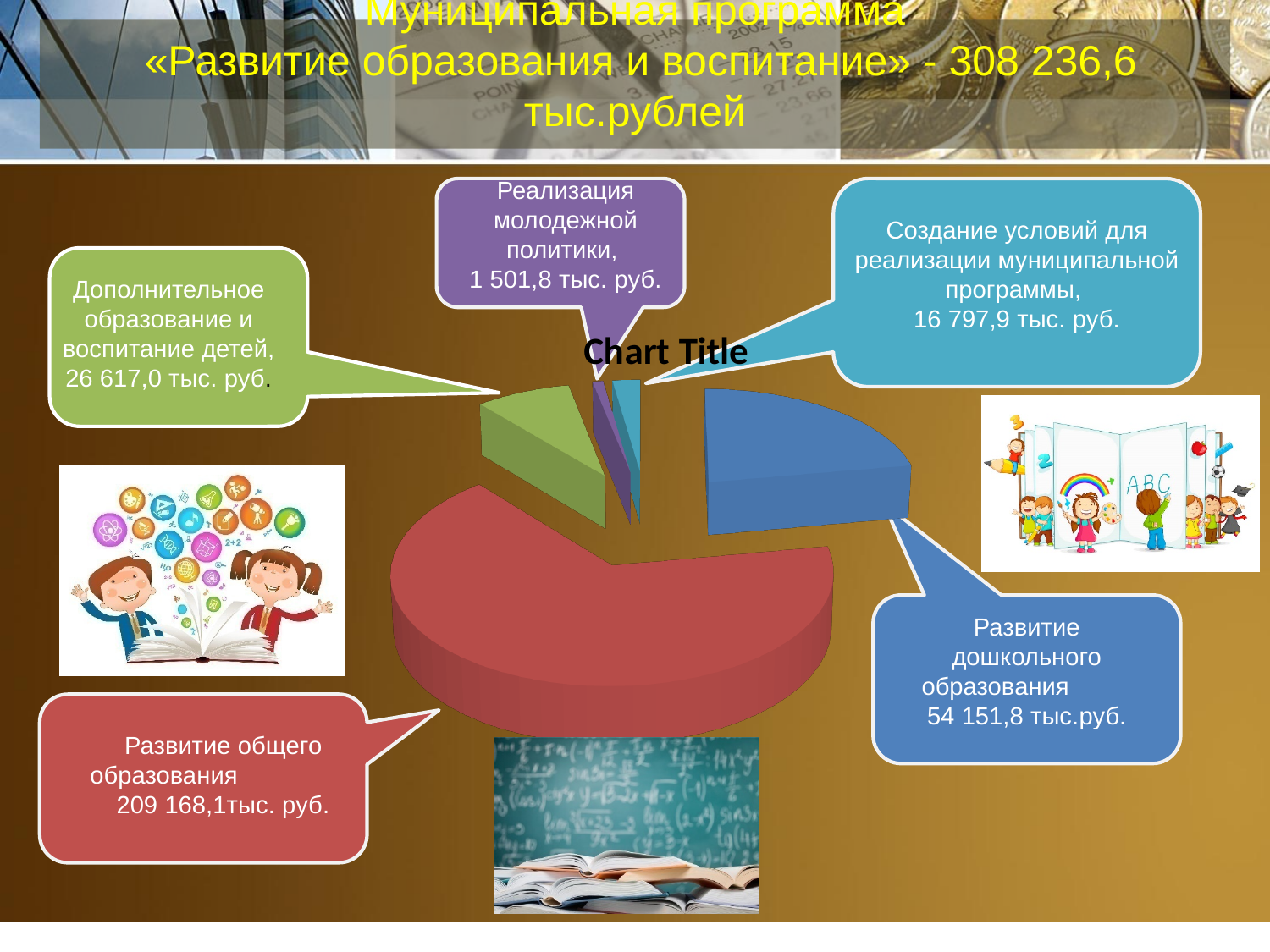
Which category has the smallest slice of the pie? Реализация молодежной политики What is the difference between «Развитие общего образования» and «Развитие дошкольного образования»? 155 016,3 тыс. руб. What is the value for «Развитие общего образования»? 209 168,1 тыс. руб. Which category has the largest slice of the pie? Развитие общего образования What is the value for «Развитие дошкольного образования»? 54 151,8 тыс.руб. What colour is the slice for «Развитие общего образования»? red What is the value for «Реализация молодежной политики»? 1 501,8 тыс. руб. What is the chart's title as printed above the pie? Chart Title What kind of chart is shown on the slide? pie chart What is the value for «Создание условий для реализации муниципальной программы»? 16 797,9 тыс. руб. Which is larger: «Дополнительное образование и воспитание детей» or «Создание условий для реализации муниципальной программы»? Дополнительное образование и воспитание детей How many slices does the pie chart have? 5